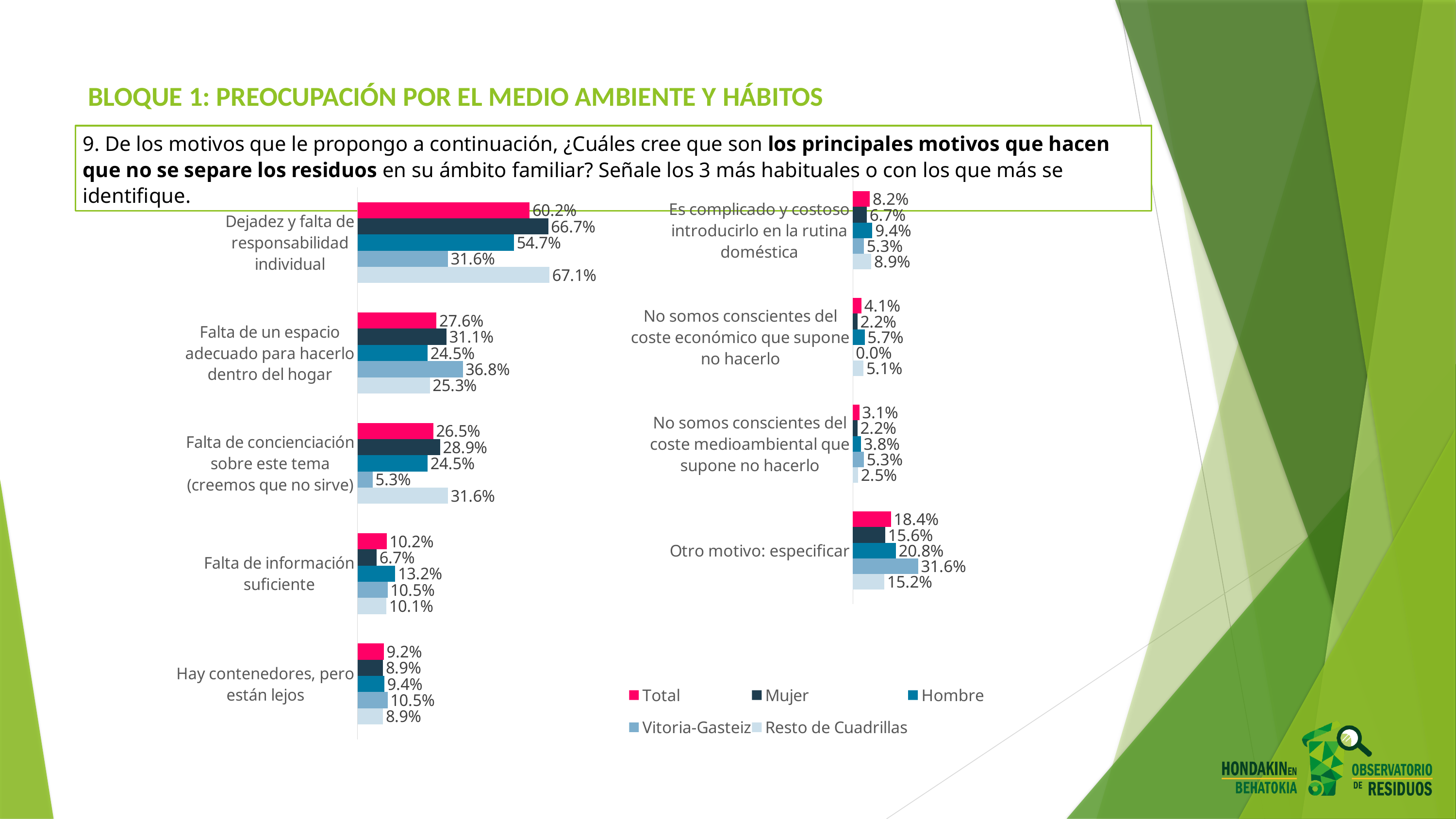
In the left chart, what is the Total value for 'Dejadez y falta de responsabilidad individual'? 60.2% In the left chart, what is the difference between the Mujer and Hombre values for 'Dejadez y falta de responsabilidad individual'? 12.0% In the left chart, for 'Falta de concienciación sobre este tema (creemos que no sirve)', which is larger: the Vitoria-Gasteiz value or the Resto de Cuadrillas value? Resto de Cuadrillas How many series does the legend list? 5 In the right chart, what is the Hombre value for 'Otro motivo: especificar'? 20.8% In the left chart, which category has the highest Total value? Dejadez y falta de responsabilidad individual How many categories are shown in the left chart? 5 In the right chart, which category has the lowest Total value? No somos conscientes del coste medioambiental que supone no hacerlo In the right chart, what is the Vitoria-Gasteiz value for 'No somos conscientes del coste económico que supone no hacerlo'? 0.0% How many categories are shown in the right chart? 4 In the left chart, what is the Vitoria-Gasteiz value for 'Falta de un espacio adecuado para hacerlo dentro del hogar'? 36.8% What kind of chart is used on this slide? Bar chart